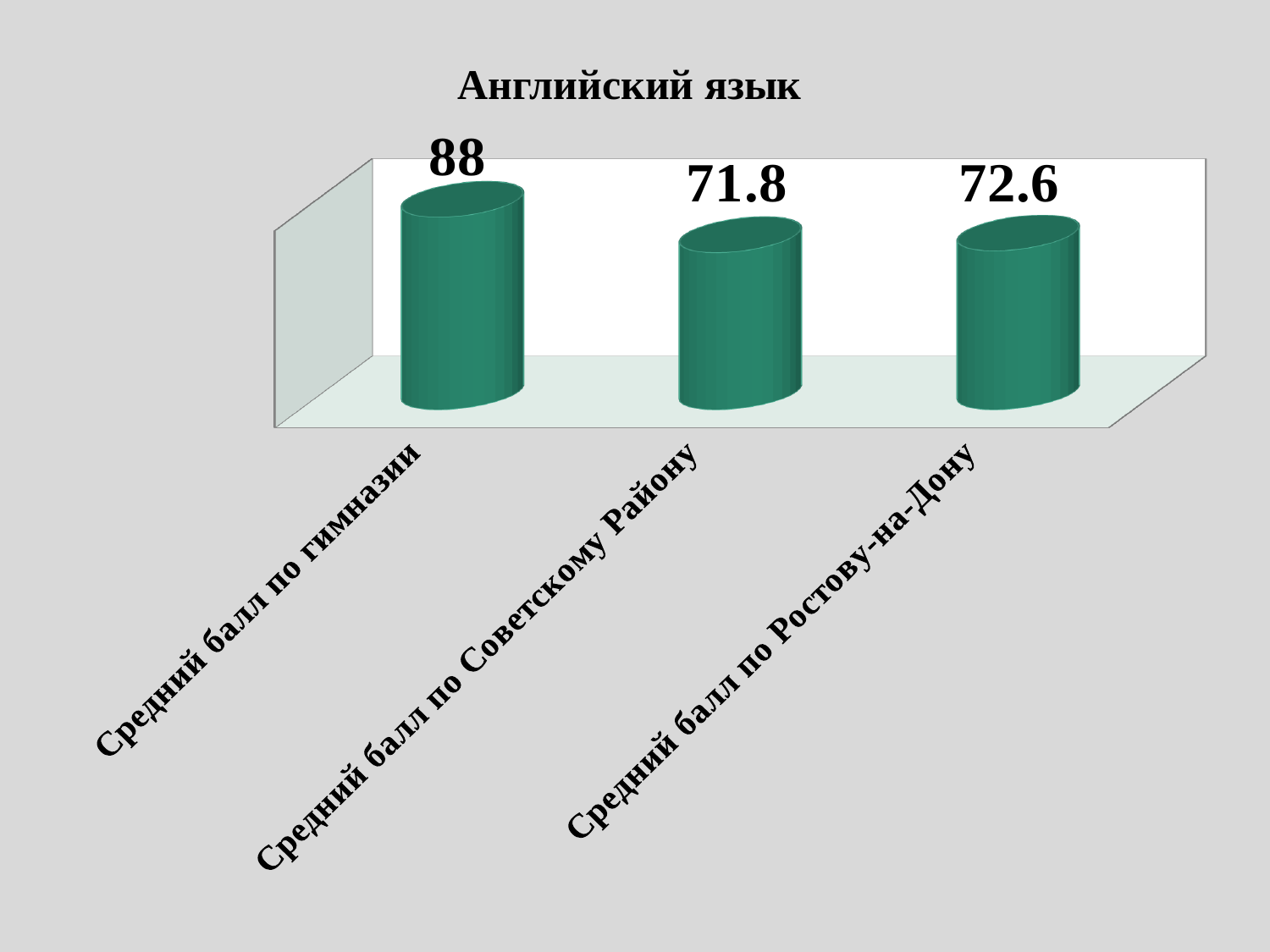
What is the value for Средний балл по гимназии? 88 What is the difference between the value for Средний балл по гимназии and the value for Средний балл по Ростову-на-Дону? 15.4 Which category has the lowest value? Средний балл по Советскому Району What kind of chart is shown on the slide? Bar chart Which category has the highest value? Средний балл по гимназии What is the value for Средний балл по Ростову-на-Дону? 72.6 What is the title of the chart? Английский язык What colour are the bars in the chart? Green What is the difference between the value for Средний балл по Ростову-на-Дону and the value for Средний балл по Советскому Району? 0.8 How many categories are shown in the chart? 3 What is the value for Средний балл по Советскому Району? 71.8 Which is larger: the value for Средний балл по гимназии or the value for Средний балл по Советскому Району? Средний балл по гимназии